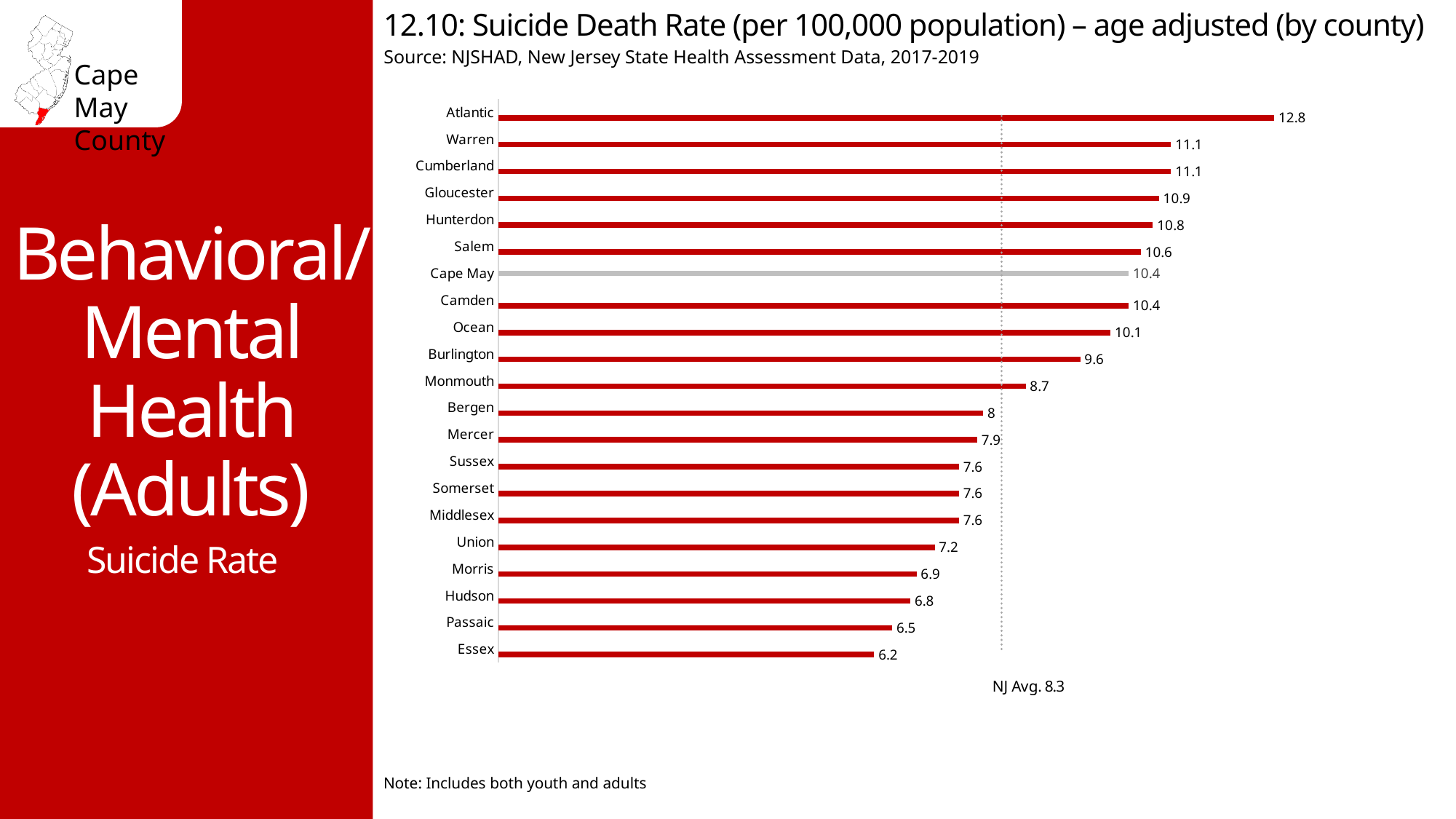
How many counties are shown in the chart? 21 What is the suicide death rate for Atlantic? 12.8 What is the suicide death rate for Cape May? 10.4 Which has a higher suicide death rate, Gloucester or Ocean? Gloucester What is the difference between the suicide death rates of Atlantic and Essex? 6.6 What is the suicide death rate for Essex? 6.2 Which county has the lowest suicide death rate? Essex What kind of chart is shown on the slide? Bar chart Which county has the highest suicide death rate? Atlantic Which county's bar is shown in grey instead of red? Cape May What is the difference between the suicide death rates of Cape May and Monmouth? 1.7 What is the NJ average suicide death rate shown on the chart? 8.3